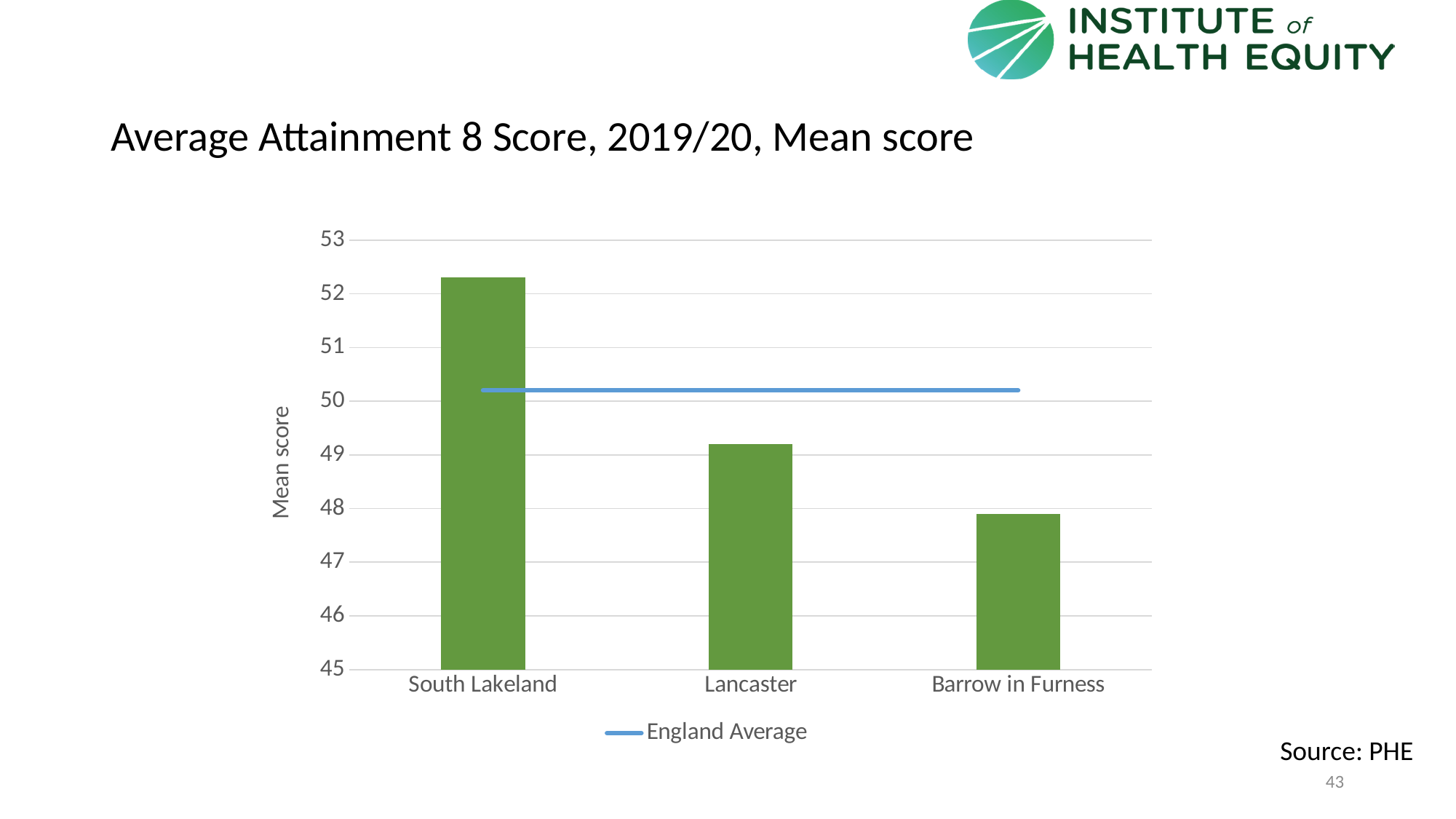
Which area has the lowest mean Attainment 8 score? Barrow in Furness Is the value for Barrow in Furness greater or less than 49? less What is the title of the chart? Average Attainment 8 Score, 2019/20, Mean score Is the England Average line greater or less than 51? less Which area has the highest mean Attainment 8 score? South Lakeland Is the value for Lancaster greater or less than 50? less How many entries does the legend list? 1 Which has a higher mean score, Lancaster or Barrow in Furness? Lancaster How many areas (bars) are shown on the chart? 3 Do the bar values rise or fall from left to right across the x axis? fall What kind of chart is shown on the slide? bar chart